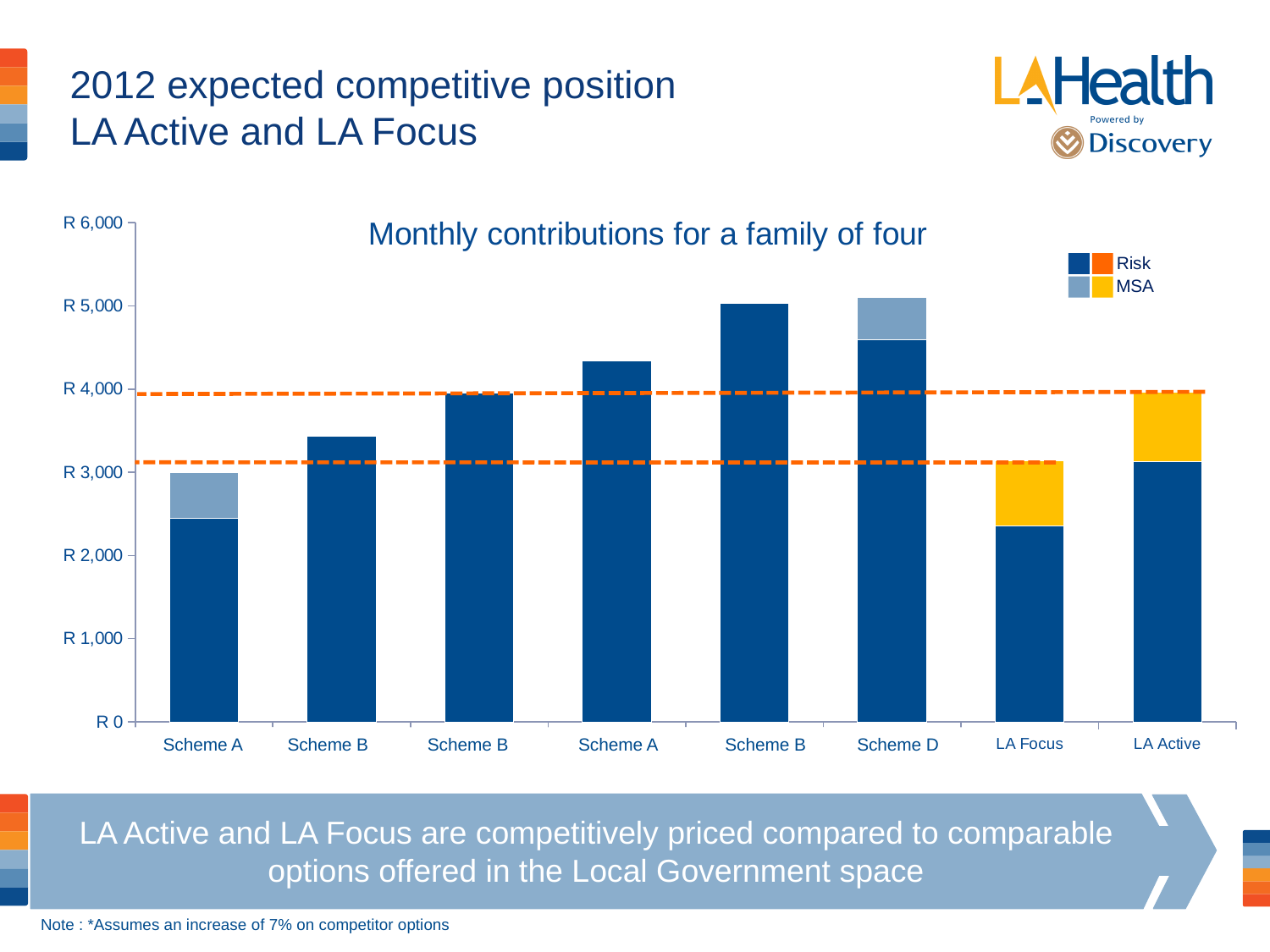
What are the two series named in the chart legend? Risk and MSA Which bar is taller: the fourth bar from the left (Scheme A) or the second bar from the left (Scheme B)? The fourth bar (Scheme A) How many series does the chart legend list? 2 What kind of chart is shown on the slide? Bar chart How many bars are plotted in the chart? 8 Which bar is taller: Scheme D or LA Focus? Scheme D Is the value of the fourth bar from the left (Scheme A) greater or less than R 4,000? greater What is the title of the chart? Monthly contributions for a family of four Is the value of the second bar from the left (Scheme B) greater or less than R 3,000? greater Is the total value of the LA Active bar greater or less than R 3,000? greater